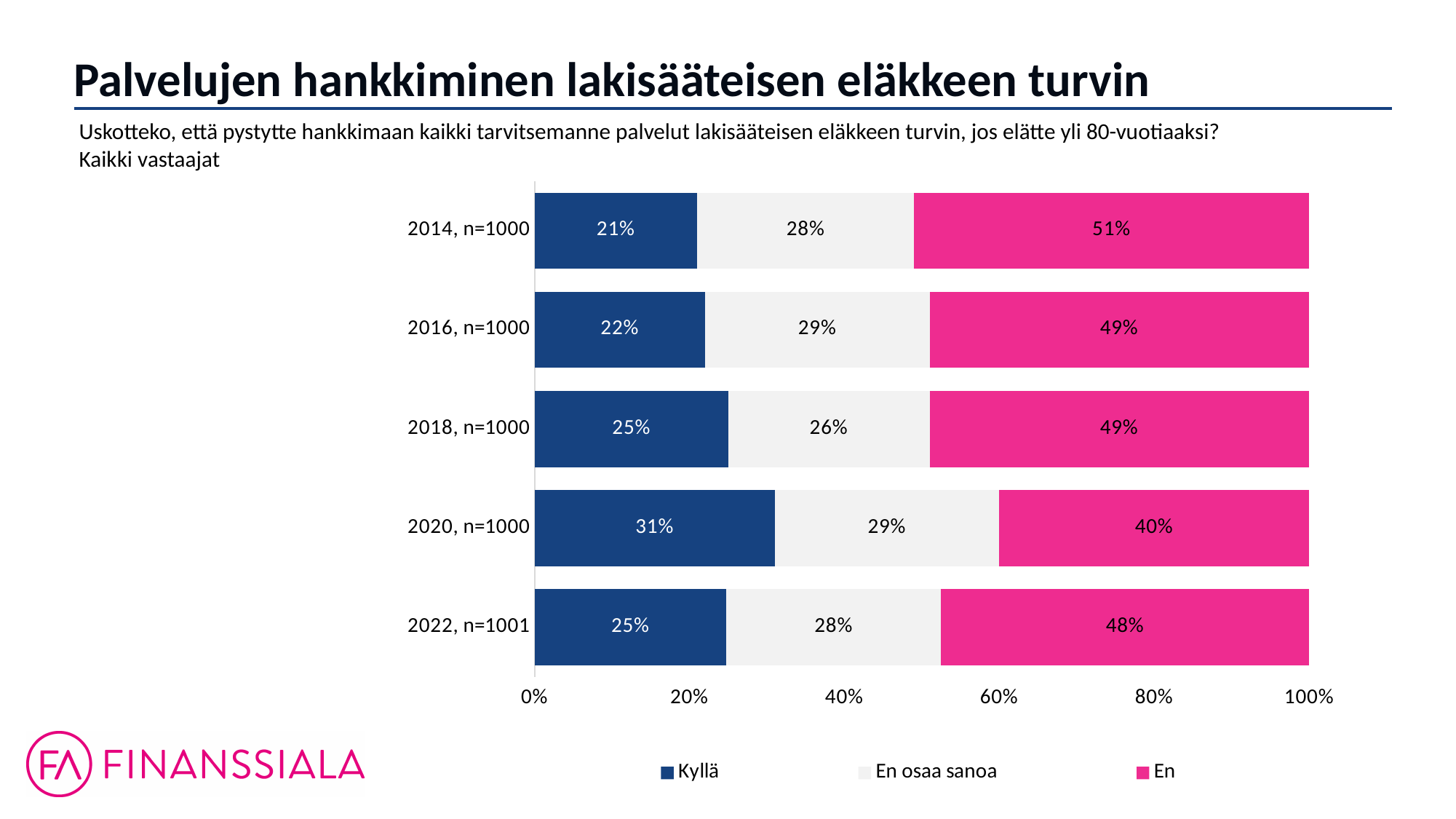
What percentage answered "En" in 2022, n=1001? 48% What percentage answered "En osaa sanoa" in 2018, n=1000? 26% What is the difference between the "En" share in 2014, n=1000 and in 2020, n=1000? 11 percentage points How many series does the legend list? 3 In which year was the "Kyllä" share highest? 2020, n=1000 What percentage answered "En" in 2014, n=1000? 51% What kind of chart is shown on the slide? Stacked bar chart How many year categories are shown in the chart? 5 What percentage answered "Kyllä" in 2020, n=1000? 31% In which year was the "En" share lowest? 2020, n=1000 Which is larger: the "Kyllä" share in 2016, n=1000 or in 2018, n=1000? 2018, n=1000 Which colour represents the "En" series in the chart? Pink